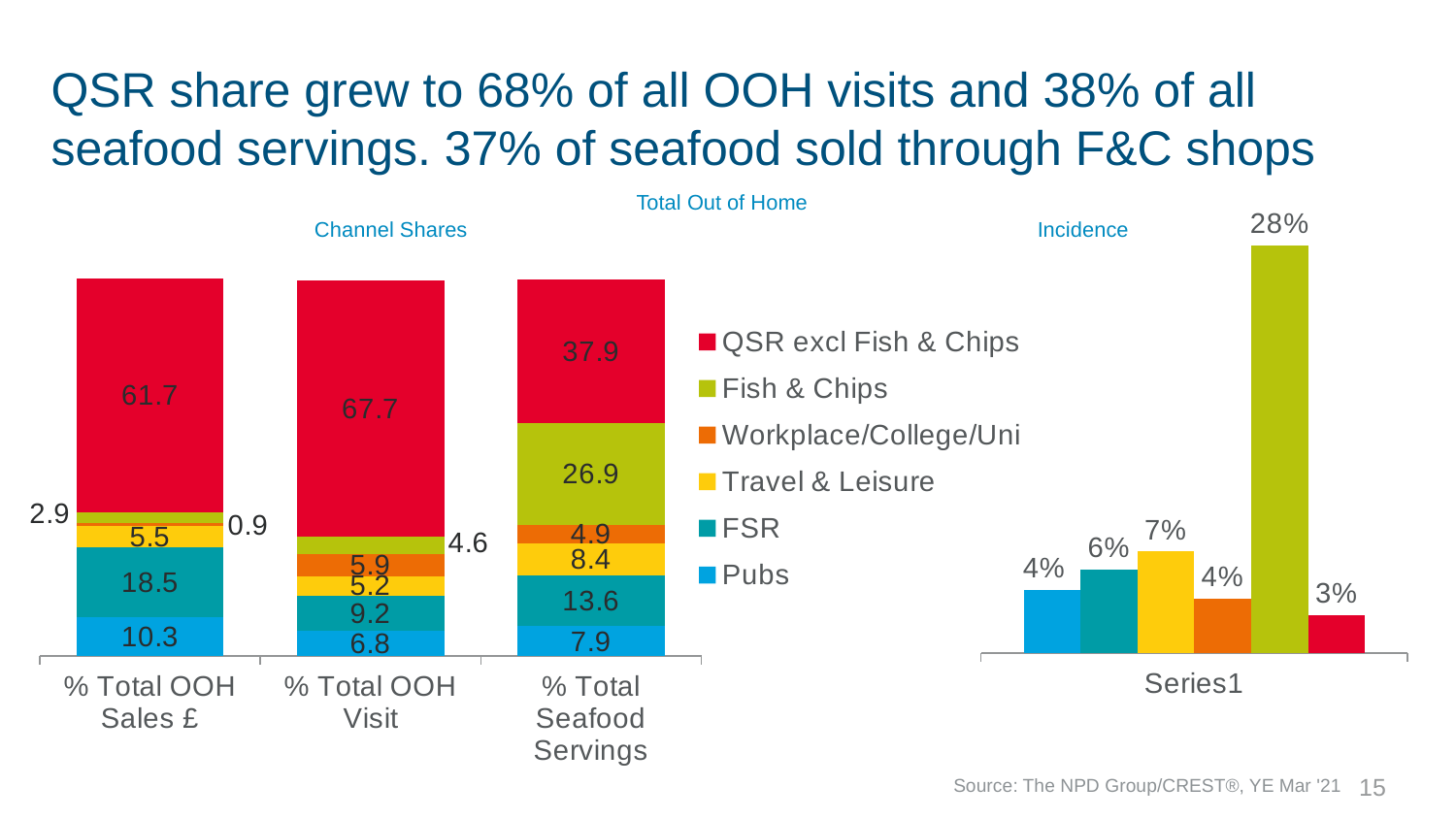
In the Channel Shares chart, what is the value for Fish & Chips in the % Total Seafood Servings bar? 26.9 In the Incidence chart, which bar is the lowest? QSR excl Fish & Chips In the Channel Shares chart, what is the value for FSR in the % Total OOH Sales £ bar? 18.5 In the Channel Shares chart, which segment is the smallest in the % Total OOH Sales £ bar? Workplace/College/Uni How many categories are shown on the x axis of the Channel Shares chart? 3 In the Channel Shares chart, what is the difference between the Fish & Chips values for % Total Seafood Servings and % Total OOH Visit? 22.3 In the Channel Shares chart, is the FSR value larger for % Total OOH Sales £ or for % Total Seafood Servings? % Total OOH Sales £ How many series does the legend list? 6 In the Channel Shares chart, which segment is the largest in the % Total Seafood Servings bar? QSR excl Fish & Chips In the Channel Shares chart, what is the value for QSR excl Fish & Chips in the % Total OOH Visit bar? 67.7 In the Incidence chart, what is the value of the Fish & Chips bar? 28% In the Channel Shares chart, what is the value for Pubs in the % Total OOH Visit bar? 6.8